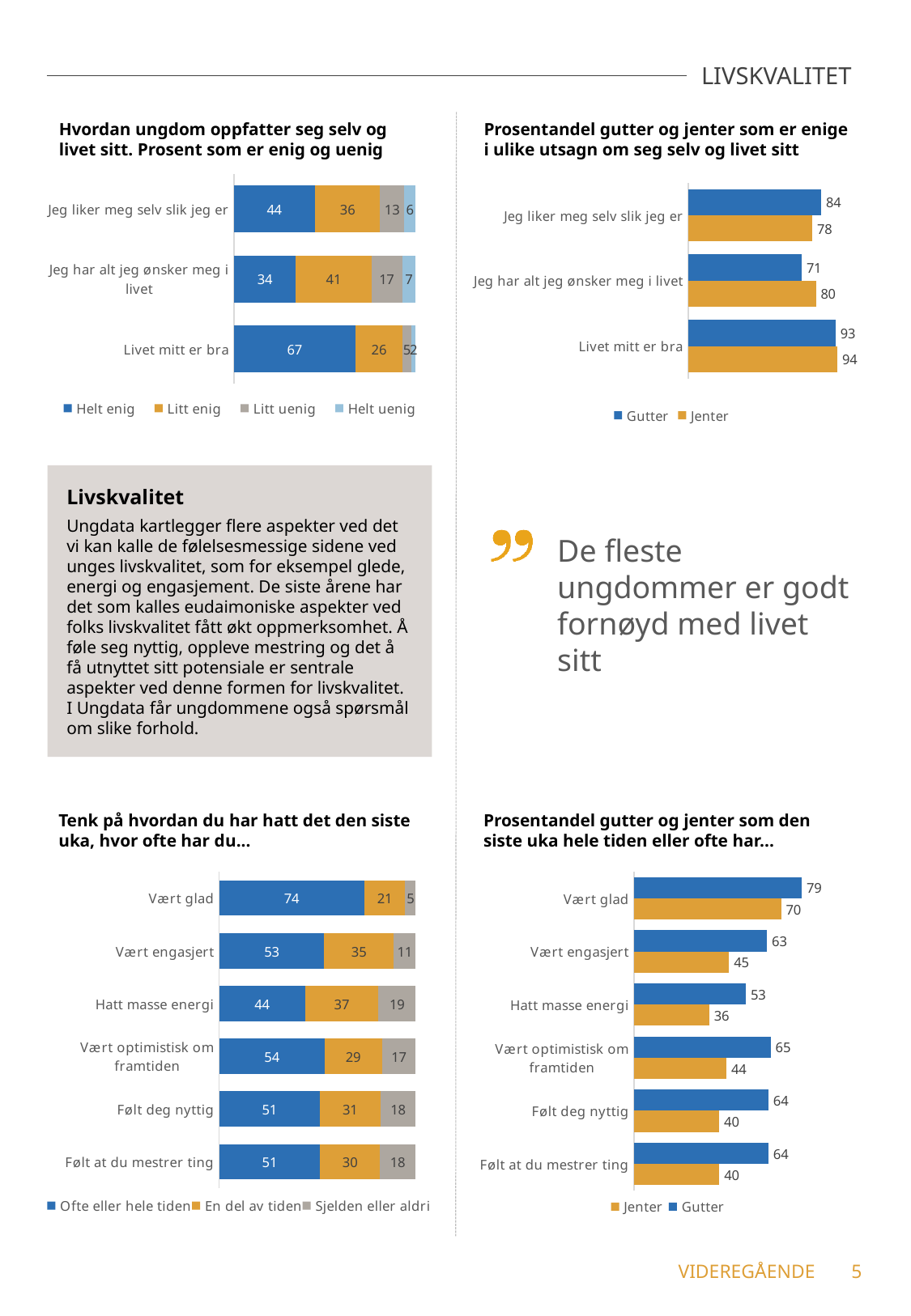
In the chart 'Prosentandel gutter og jenter som er enige i ulike utsagn om seg selv og livet sitt', what is the difference between Gutter and Jenter for 'Jeg liker meg selv slik jeg er'? 6 In the chart 'Prosentandel gutter og jenter som den siste uka hele tiden eller ofte har…', what is the Jenter value for 'Vært glad'? 70 In the chart 'Hvordan ungdom oppfatter seg selv og livet sitt', what is the 'Helt enig' value for 'Livet mitt er bra'? 67 How many series does the legend list in the chart 'Hvordan ungdom oppfatter seg selv og livet sitt'? 4 In the chart 'Hvordan ungdom oppfatter seg selv og livet sitt', what is the 'Litt enig' value for 'Jeg har alt jeg ønsker meg i livet'? 41 In the chart 'Prosentandel gutter og jenter som er enige i ulike utsagn om seg selv og livet sitt', what is the Jenter value for 'Jeg har alt jeg ønsker meg i livet'? 80 In the chart 'Tenk på hvordan du har hatt det den siste uka, hvor ofte har du…', which category has the lowest 'Sjelden eller aldri' value? Vært glad In the chart 'Tenk på hvordan du har hatt det den siste uka, hvor ofte har du…', what is the 'Ofte eller hele tiden' value for 'Hatt masse energi'? 44 In the chart 'Prosentandel gutter og jenter som er enige i ulike utsagn om seg selv og livet sitt', which statement has the highest Gutter value? Livet mitt er bra How many categories are shown in the chart 'Tenk på hvordan du har hatt det den siste uka, hvor ofte har du…'? 6 What type of chart is 'Tenk på hvordan du har hatt det den siste uka, hvor ofte har du…'? Stacked bar chart In the chart 'Prosentandel gutter og jenter som den siste uka hele tiden eller ofte har…', which is larger for 'Hatt masse energi': Gutter or Jenter? Gutter